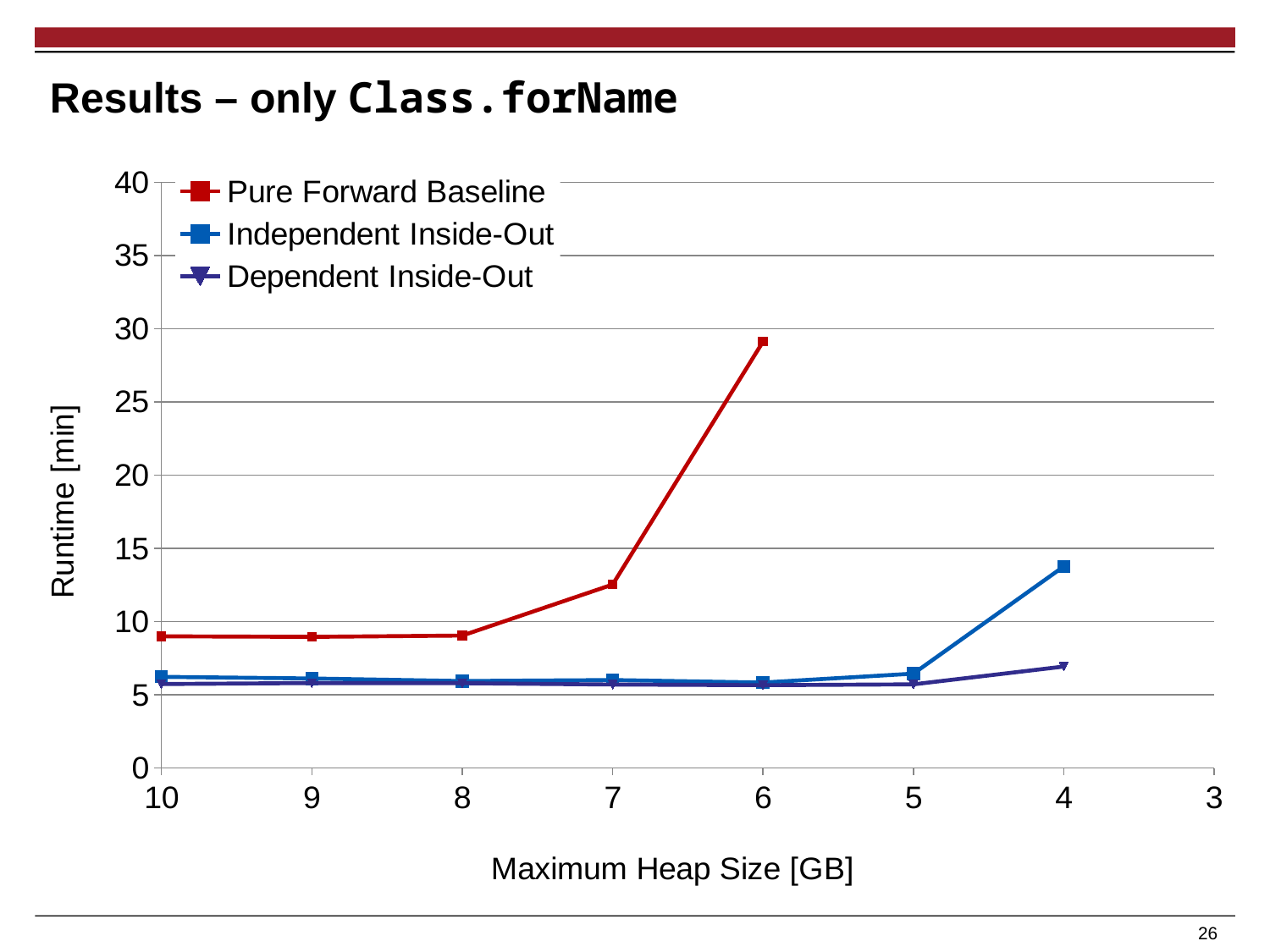
At a maximum heap size of 4 GB, which has the higher runtime: Independent Inside-Out or Dependent Inside-Out? Independent Inside-Out Is the runtime for Pure Forward Baseline at a maximum heap size of 10 GB greater or less than 10? less Is the runtime for Pure Forward Baseline at a maximum heap size of 6 GB greater or less than 25? greater What kind of chart is shown on the slide? line chart How many series does the legend list? 3 What is the label of the y axis? Runtime [min] Which series reaches the highest runtime anywhere on the chart? Pure Forward Baseline Is the runtime for Dependent Inside-Out at a maximum heap size of 4 GB greater or less than 10? less At a maximum heap size of 6 GB, which has the higher runtime: Pure Forward Baseline or Independent Inside-Out? Pure Forward Baseline What is the label of the x axis? Maximum Heap Size [GB] How many data points are plotted for the Pure Forward Baseline series? 5